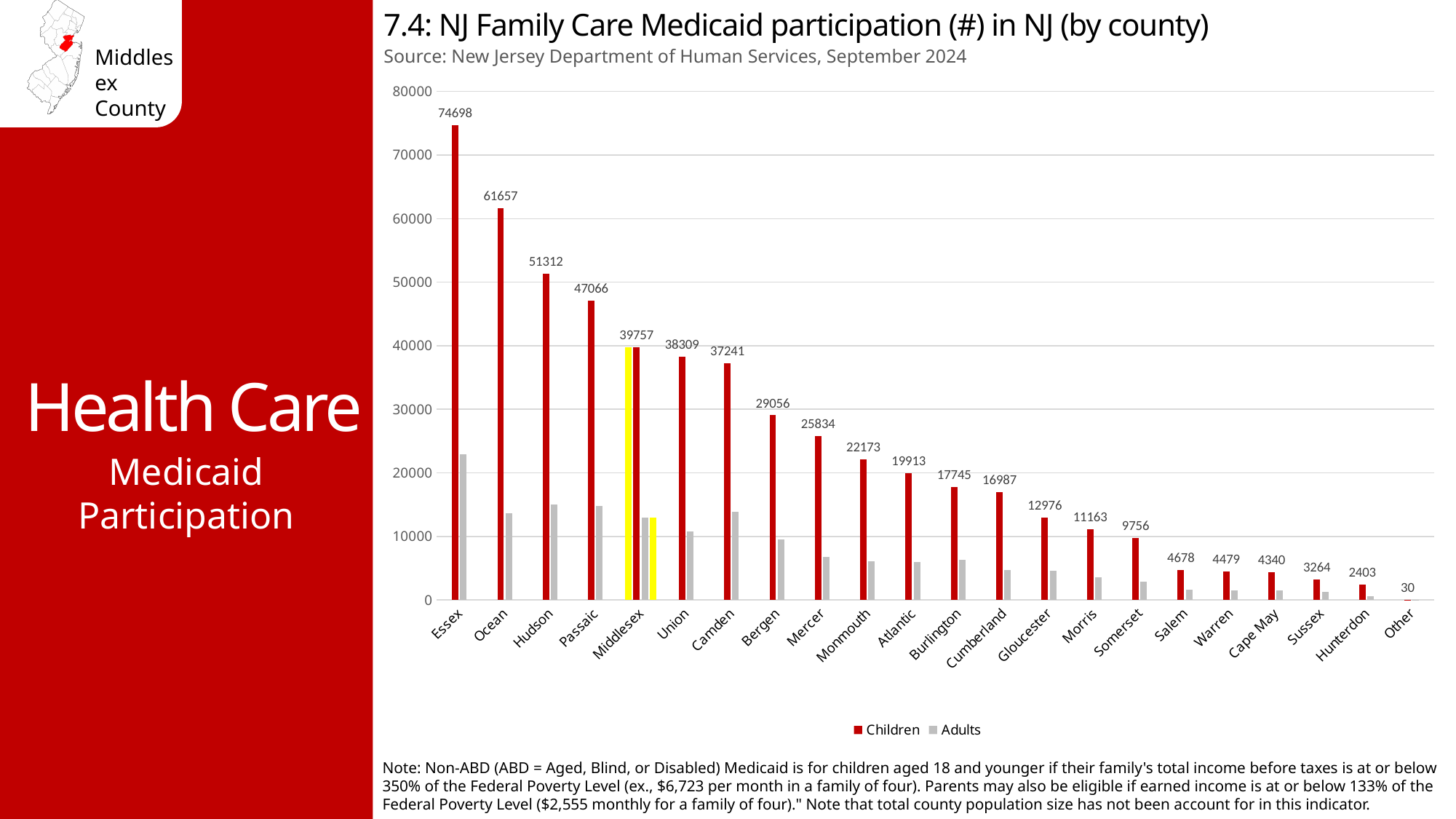
What is the Children value for Bergen? 29056 Is the Adults value for Essex greater or less than 20000? greater What is the Children value for Middlesex? 39757 Do the Children values rise or fall from left to right along the x axis? Fall What is the difference between the Children values for Essex and Ocean? 13041 Which county has the highest Children value? Essex Which category has the lowest Children value? Other How many categories are shown on the x axis? 22 Is the Adults value for Hunterdon greater or less than 10000? less Which has a larger Children value, Hudson or Passaic? Hudson What kind of chart is shown? Bar chart How many series does the legend list? 2